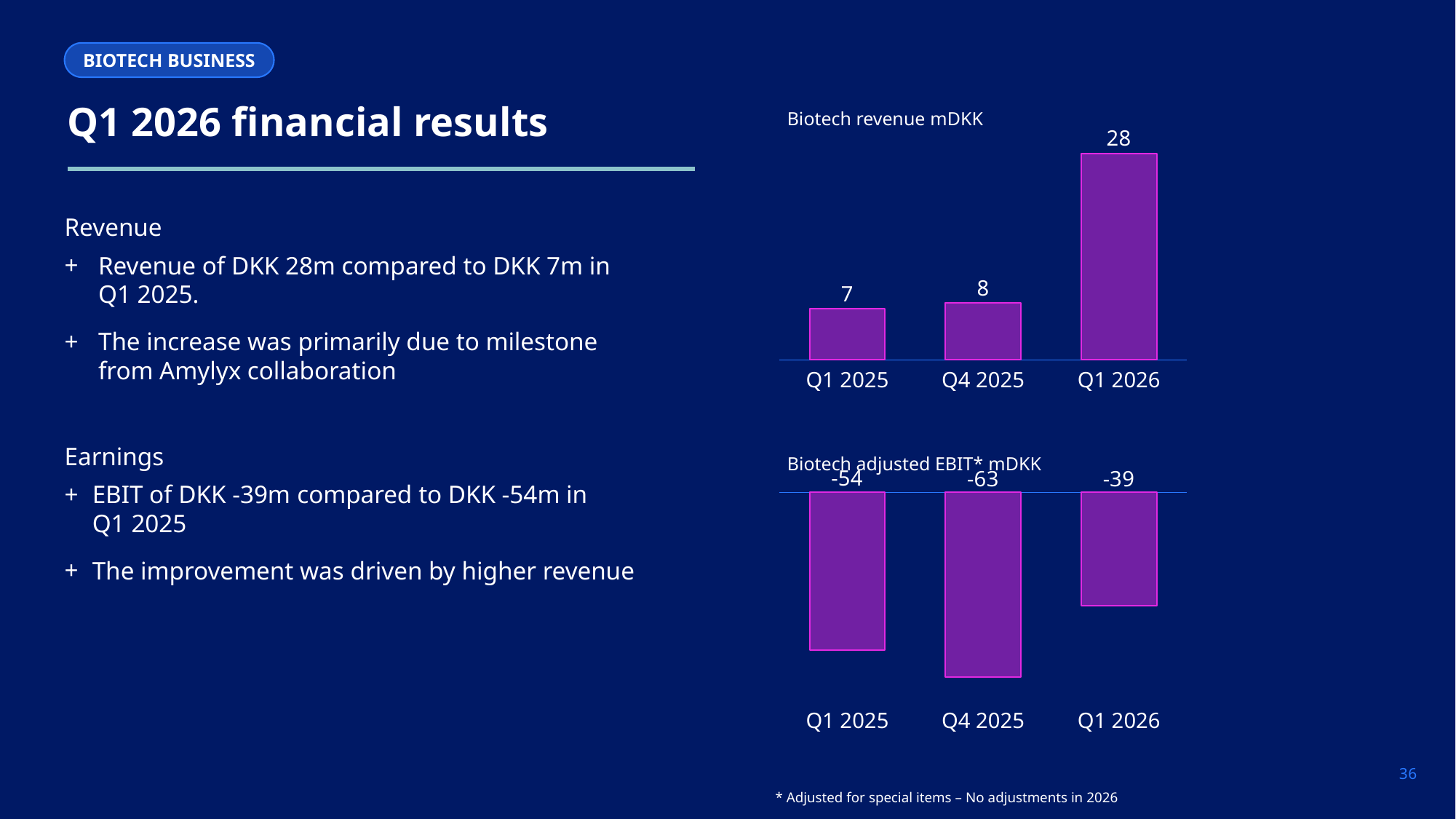
In the 'Biotech revenue mDKK' chart, what is the difference between the Q1 2026 and Q1 2025 values? 21 In the 'Biotech adjusted EBIT* mDKK' chart, what is the difference between the Q1 2025 and Q4 2025 values? 9 In the 'Biotech revenue mDKK' chart, what is the value for Q1 2026? 28 What type of chart is the 'Biotech revenue mDKK' chart? Bar chart In the 'Biotech revenue mDKK' chart, what is the value for Q4 2025? 8 In the 'Biotech adjusted EBIT* mDKK' chart, which quarter has the lowest value? Q4 2025 In the 'Biotech revenue mDKK' chart, how many quarters are shown? 3 In the 'Biotech adjusted EBIT* mDKK' chart, which is larger, the value for Q1 2025 or Q1 2026? Q1 2026 In the 'Biotech revenue mDKK' chart, which quarter has the highest value? Q1 2026 In the 'Biotech revenue mDKK' chart, which quarter has the lowest value? Q1 2025 In the 'Biotech adjusted EBIT* mDKK' chart, what is the value for Q1 2026? -39 In the 'Biotech adjusted EBIT* mDKK' chart, what is the value for Q4 2025? -63